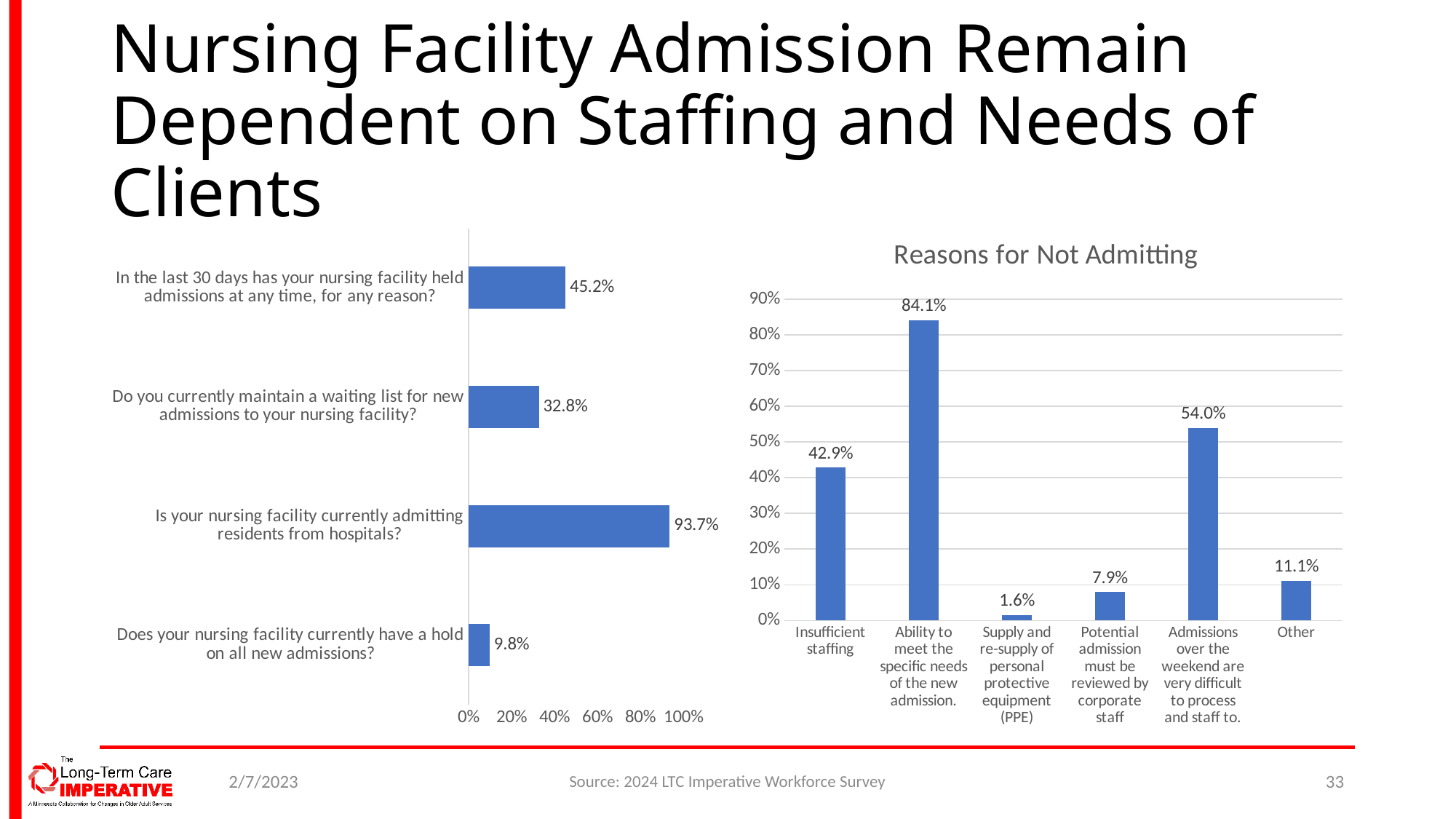
In the 'Reasons for Not Admitting' chart, what is the difference between the value for Other and the value for Potential admission must be reviewed by corporate staff? 3.2% What type of chart is the 'Reasons for Not Admitting' chart? Bar chart In the left chart, which question has the lowest percentage? Does your nursing facility currently have a hold on all new admissions? In the 'Reasons for Not Admitting' chart, how many reasons are shown? 6 In the left chart, what is the difference between the percentage that held admissions in the last 30 days and the percentage that maintain a waiting list? 12.4% In the 'Reasons for Not Admitting' chart, which reason has the lowest value? Supply and re-supply of personal protective equipment (PPE) In the left chart, what percentage of facilities currently maintain a waiting list for new admissions? 32.8% In the left chart, what percentage of nursing facilities currently have a hold on all new admissions? 9.8% In the 'Reasons for Not Admitting' chart, which reason has the highest value? Ability to meet the specific needs of the new admission. In the 'Reasons for Not Admitting' chart, which is larger: Insufficient staffing or Admissions over the weekend are very difficult to process and staff to? Admissions over the weekend are very difficult to process and staff to. In the 'Reasons for Not Admitting' chart, what is the value for Insufficient staffing? 42.9% In the left chart, what percentage of nursing facilities are currently admitting residents from hospitals? 93.7%